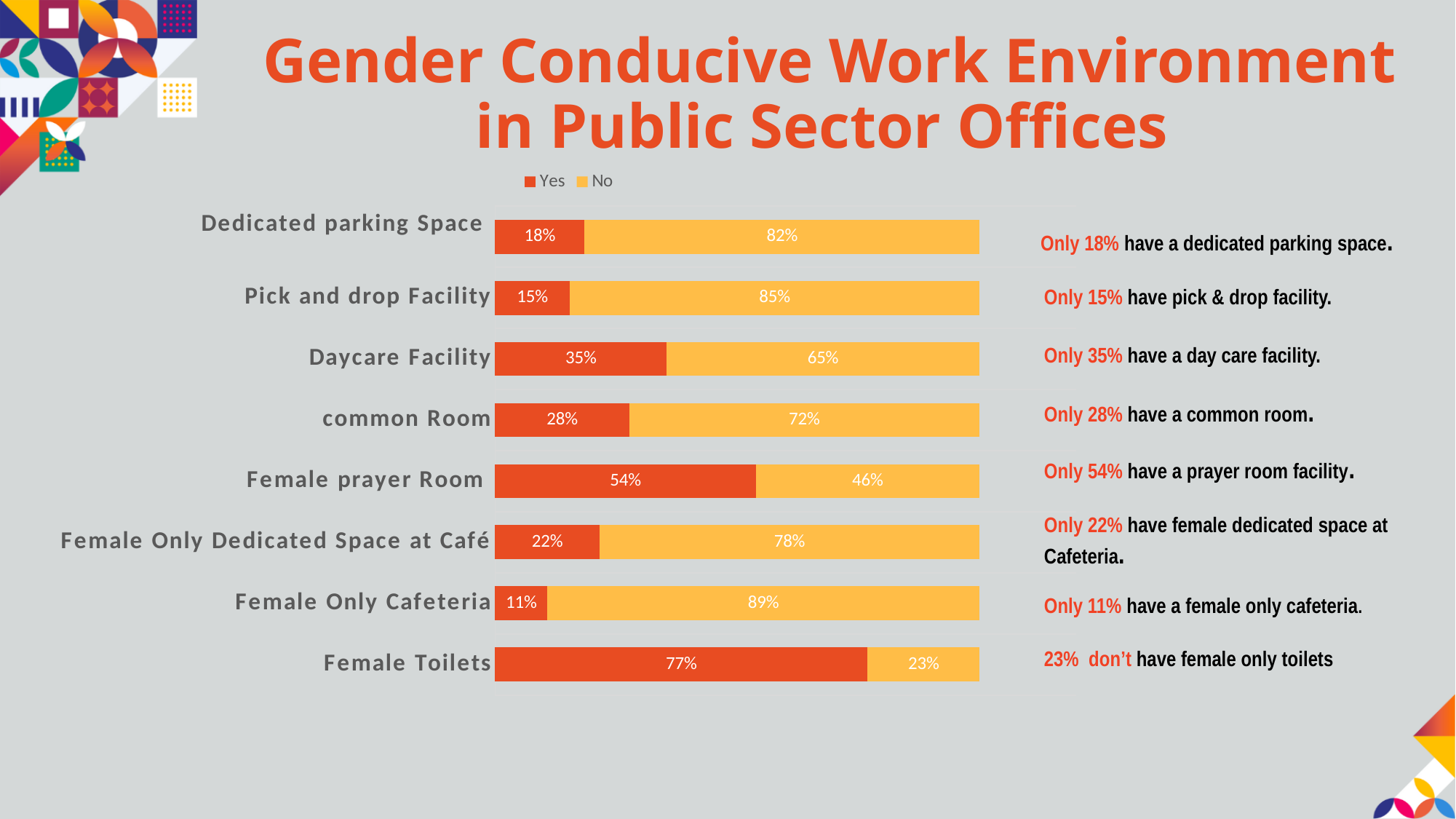
What is the difference between the 'No' values for Dedicated parking Space and Female Toilets? 59% Which category has the lowest 'Yes' value? Female Only Cafeteria Which category has the highest 'Yes' value? Female Toilets Which colour represents the 'No' series in the chart? Yellow What is the 'Yes' value for Female prayer Room? 54% What kind of chart is shown on the slide? Stacked bar chart Which is larger, the 'Yes' value for common Room or the 'Yes' value for Female Only Dedicated Space at Café? common Room What is the 'Yes' value for Daycare Facility? 35% How many series does the legend list? 2 What is the 'No' value for Female Only Cafeteria? 89% What is the total of the stacked bar for Pick and drop Facility? 100% How many categories are shown in the chart? 8